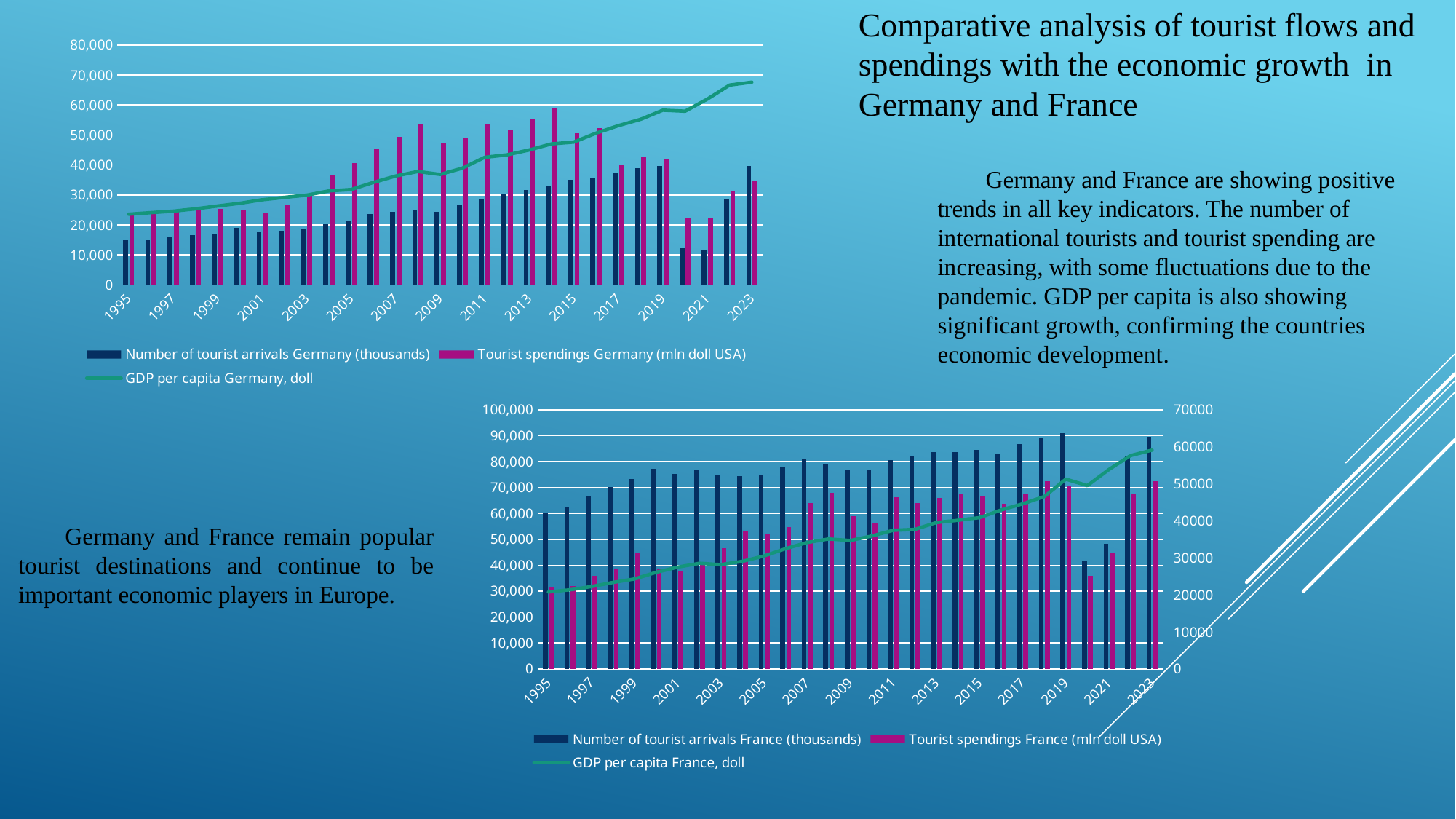
On the Germany chart (top left), does the GDP per capita Germany, doll line generally rise or fall from 1995 to 2023? Rise On the France chart (bottom right), which is larger in 1995: Number of tourist arrivals France (thousands) or Tourist spendings France (mln doll USA)? Number of tourist arrivals France (thousands) On the Germany chart (top left), how many series does the legend list? 3 On the France chart (bottom right), is the value of Number of tourist arrivals France (thousands) in 2019 greater or less than 80,000? greater On the Germany chart (top left), how many years are plotted along the x axis? 29 On the France chart (bottom right), in which year is Number of tourist arrivals France (thousands) lowest? 2020 On the Germany chart (top left), is the value of Tourist spendings Germany (mln doll USA) in 2014 greater or less than 50,000? greater On the Germany chart (top left), in which year is Tourist spendings Germany (mln doll USA) highest? 2014 On the France chart (bottom right), how many series does the legend list? 3 What kind of chart is the France chart (bottom right)? Bar chart with a line series On the Germany chart (top left), which is larger in 2014: Number of tourist arrivals Germany (thousands) or Tourist spendings Germany (mln doll USA)? Tourist spendings Germany (mln doll USA) On the France chart (bottom right), is the value of Number of tourist arrivals France (thousands) in 2021 greater or less than 50,000? less